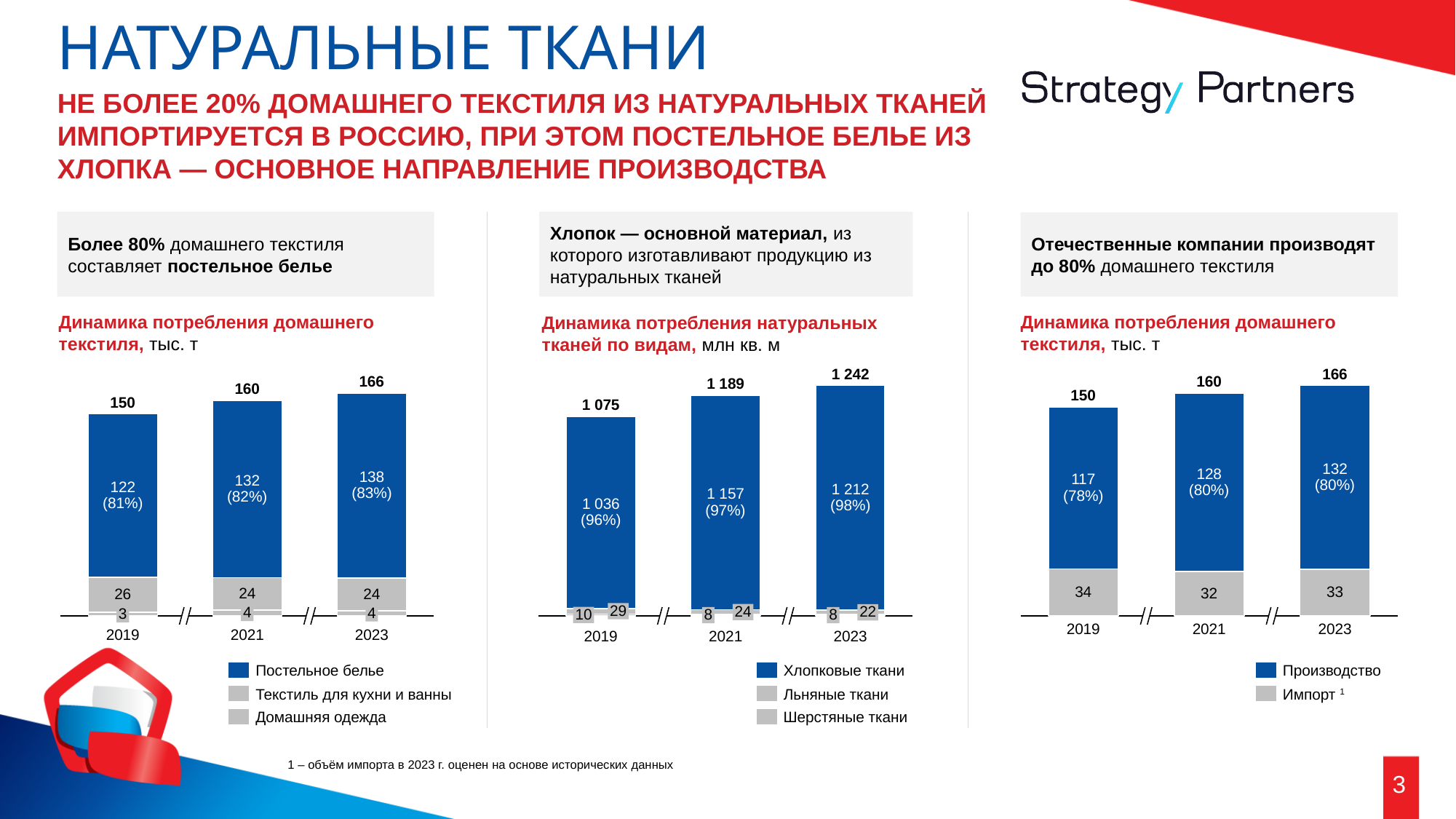
In the left chart, what share of the 2021 total does Постельное белье account for? 82% In the middle chart, how many series does the legend list? 3 In the right chart (Производство / Импорт), what is the value for Импорт in 2021? 32 In the middle chart (Динамика потребления натуральных тканей по видам), what is the total value for 2021? 1 189 In the middle chart, what is the value for Хлопковые ткани in 2023? 1 212 In the left chart, what is the value for Текстиль для кухни и ванны in 2019? 26 In the right chart, what is the difference between Производство in 2023 and Производство in 2019? 15 In the right chart, do the total values rise or fall from 2019 to 2023? rise In the left chart, what is the value for Постельное белье in 2019? 122 In the middle chart, what is the value for Шерстяные ткани in 2019? 10 In the middle chart, which year has the highest total? 2023 In the left chart (Динамика потребления домашнего текстиля, тыс. т), what is the total value for 2023? 166